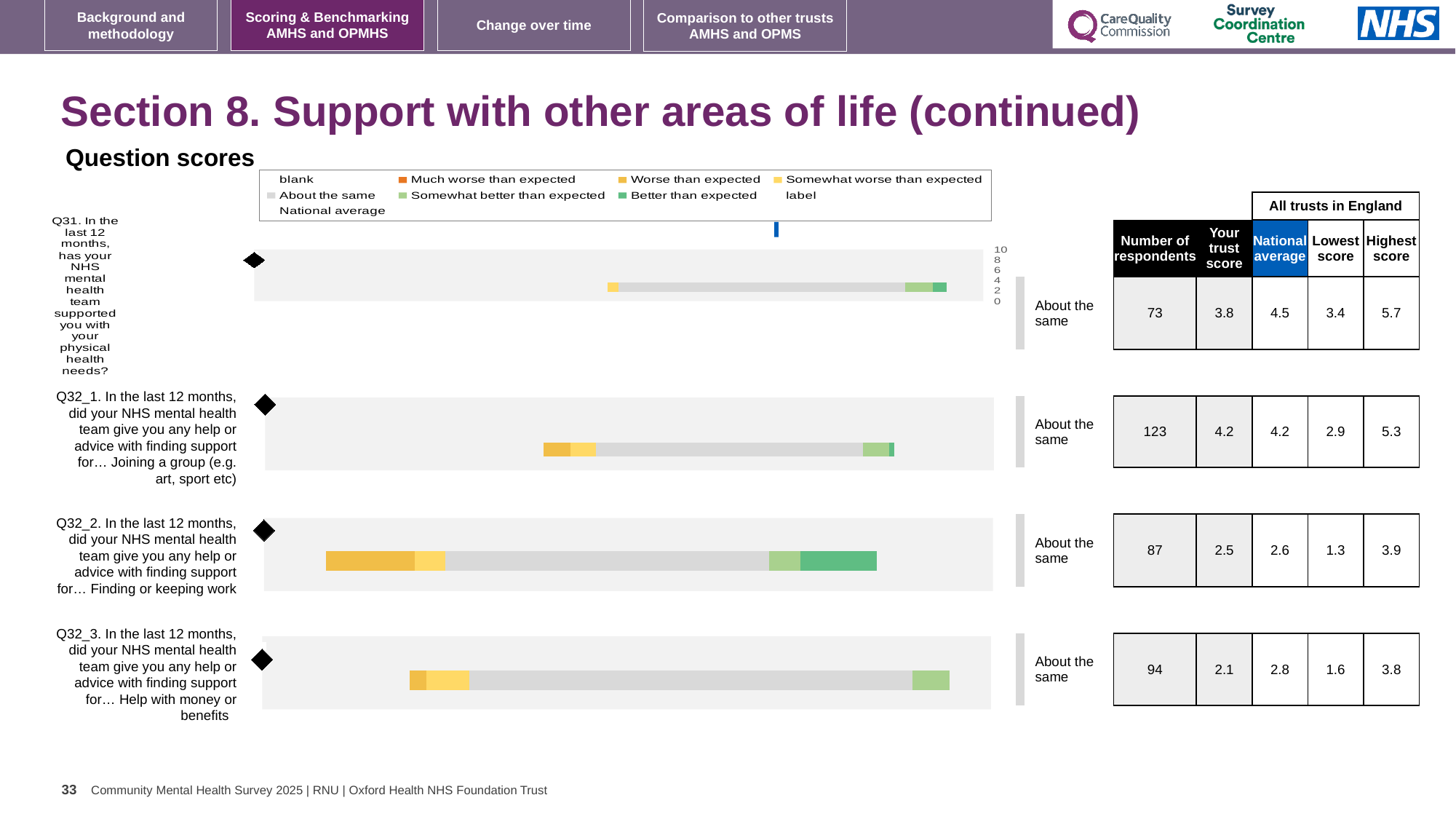
In the table beside the chart, which question has the highest number of respondents? Q32_1 (Joining a group) What kind of chart is used to show the question scores on this slide? bar chart In the legend of the question scores chart, which category is shown in orange? Much worse than expected In the table beside the chart, how many respondents answered Q32_3 (Help with money or benefits)? 94 In the table beside the chart, what is the trust score for Q31 (support with physical health needs)? 3.8 What benchmark label is shown next to the bar for Q32_2 (Finding or keeping work)? About the same How many questions (bars) are plotted in the question scores chart? 4 In the table beside the chart, what is the national average for Q32_3 (Help with money or benefits)? 2.8 In the table beside the chart, which question has the lowest trust score? Q32_3 (Help with money or benefits) In the table beside the chart, what is the difference between the highest score and the lowest score for Q31? 2.3 How many entries does the legend of the question scores chart list? 9 In the table beside the chart, is the trust score for Q32_2 (Finding or keeping work) higher or lower than the national average? lower